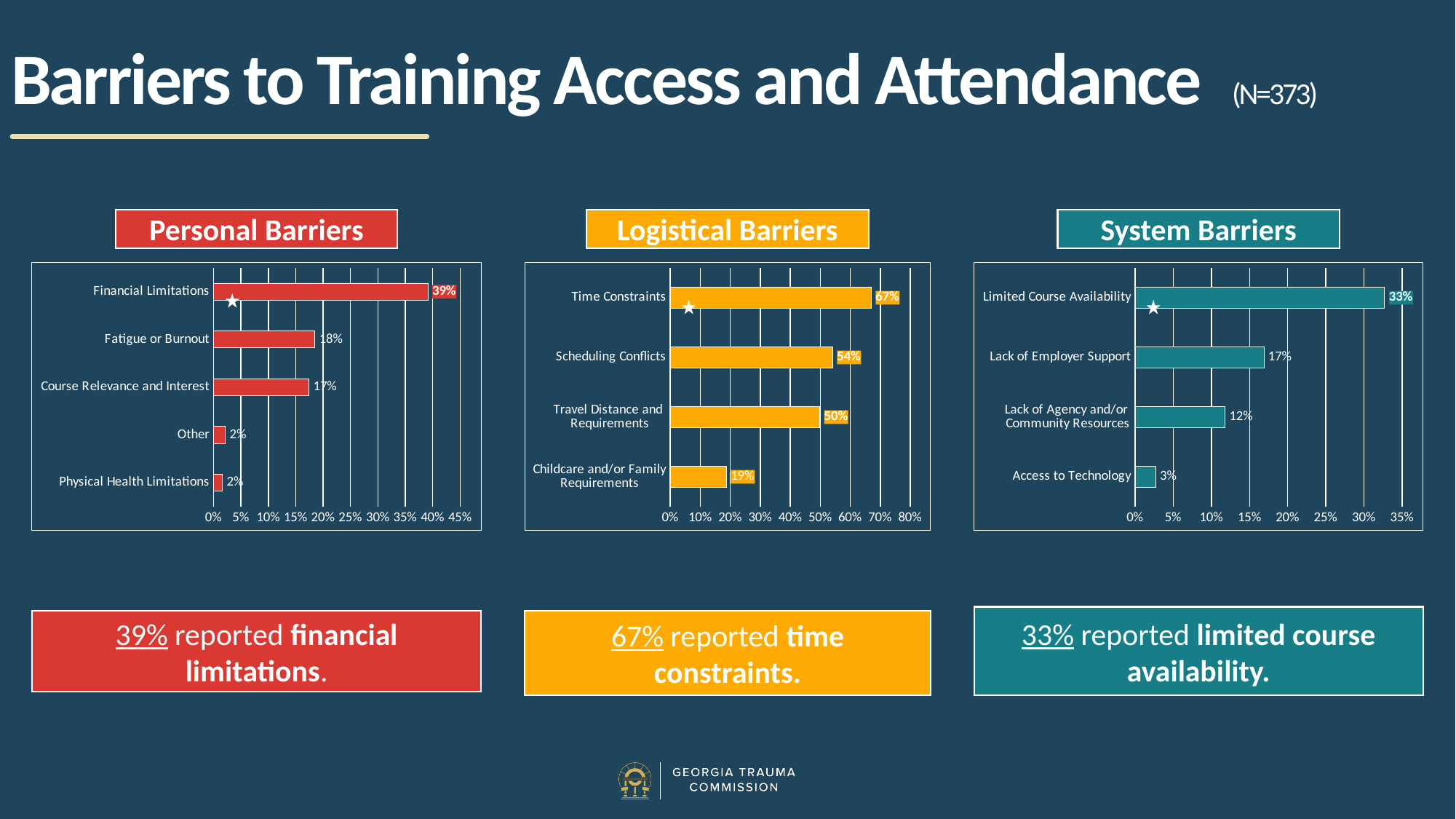
In the System Barriers chart, which category has the lowest value? Access to Technology In the Personal Barriers chart, which is larger: Fatigue or Burnout or Course Relevance and Interest? Fatigue or Burnout In the Logistical Barriers chart, what percentage reported Scheduling Conflicts? 54% How many categories are shown in the Personal Barriers chart? 5 How many categories are shown in the Logistical Barriers chart? 4 In the Logistical Barriers chart, which category has the highest value? Time Constraints In the Personal Barriers chart, what percentage reported Financial Limitations? 39% In the Logistical Barriers chart, what is the difference between Time Constraints and Childcare and/or Family Requirements? 48% In the Personal Barriers chart, what is the value for Fatigue or Burnout? 18% In the System Barriers chart, what is the difference between Limited Course Availability and Lack of Employer Support? 16% What type of chart is the System Barriers chart? Bar chart In the Logistical Barriers chart, is the value for Travel Distance and Requirements greater or less than 40%? greater